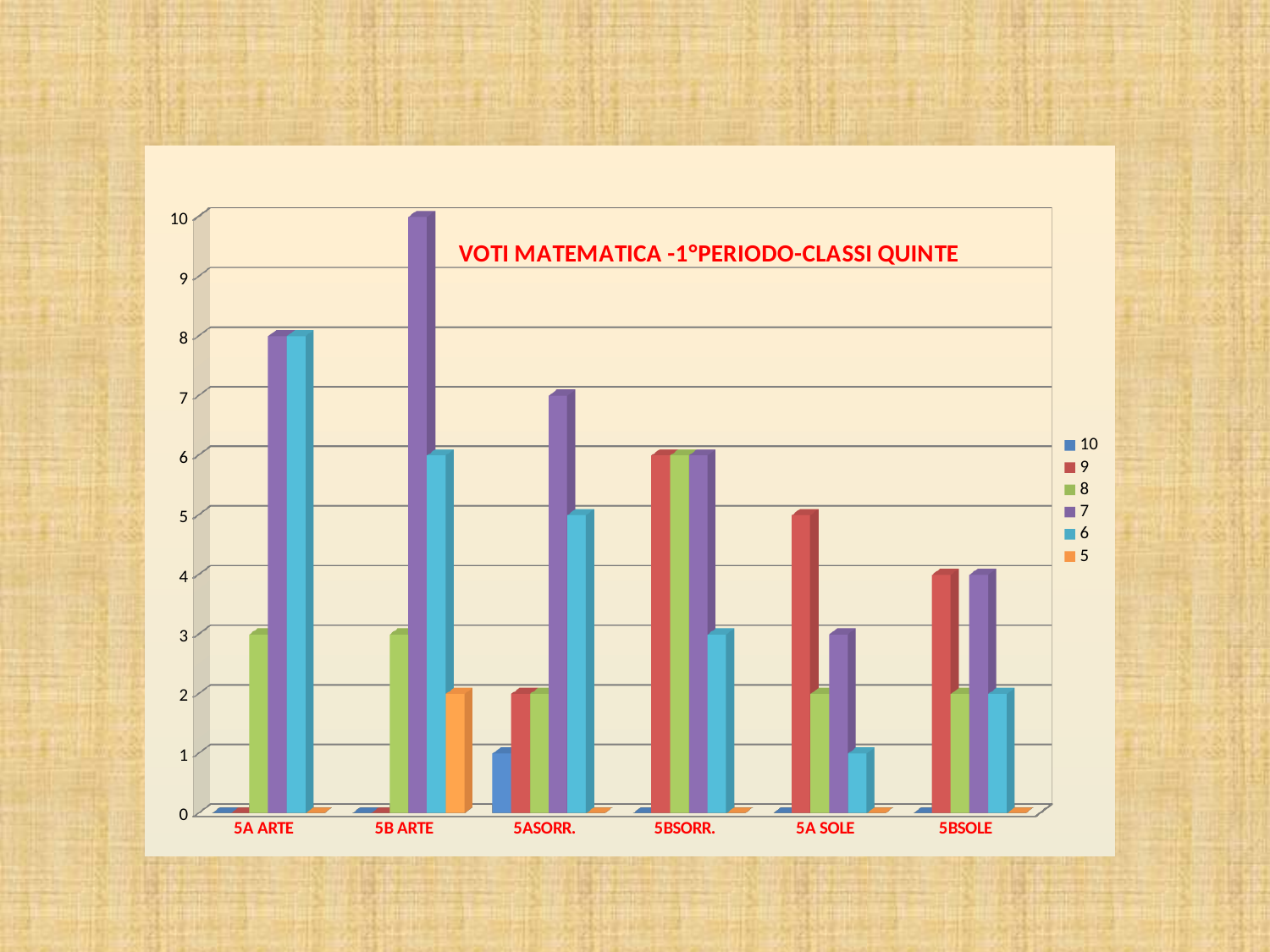
How many classes (categories) are shown on the x axis? 6 Which is larger for 5ASORR.: the series "7" or the series "6"? 7 Is the value of the series "9" for 5A SOLE greater or less than 3? greater Which class has the lowest bar for the series "6"? 5A SOLE Which is larger for 5A SOLE: the series "9" or the series "7"? 9 Which class has the highest bar for the series "7"? 5B ARTE What is the title of the chart? VOTI MATEMATICA -1°PERIODO-CLASSI QUINTE Is the value of the series "6" for 5A ARTE greater or less than 5? greater What is the value of the series "7" for 5B ARTE? 10 Which is the only class with a visible bar for the series "5"? 5B ARTE How many series does the legend list? 6 What kind of chart is shown on the slide? bar chart